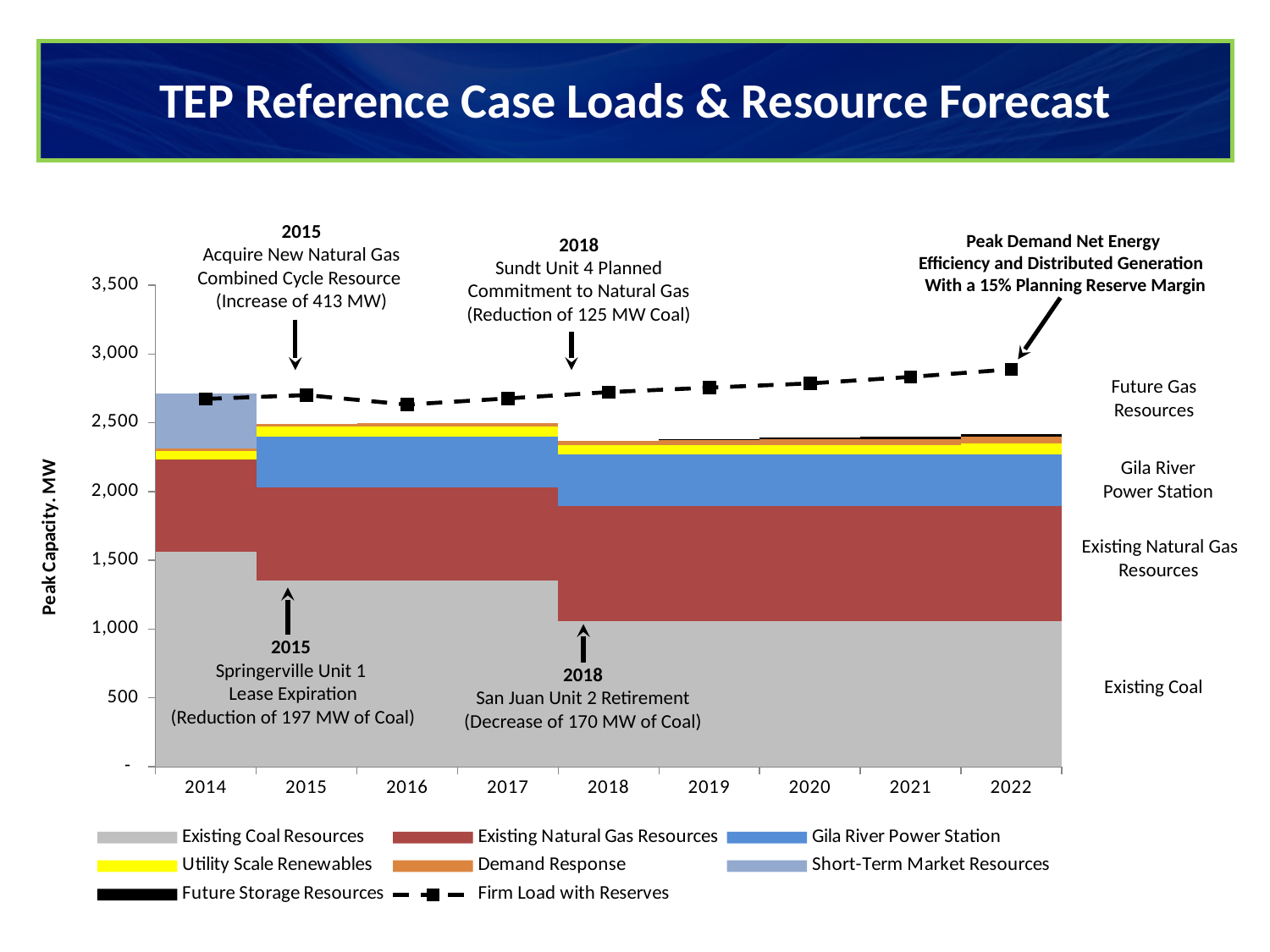
What is the label on the vertical axis of the chart? Peak Capacity, MW Is the Existing Coal Resources value for 2014 larger or smaller than the value for 2018? larger Is the Existing Coal Resources value for 2022 greater or less than 1,500? less What kind of chart is shown on the slide? Stacked bar chart with a line Is the Firm Load with Reserves value for 2022 greater or less than 3,000? less Is the total stacked capacity for 2014 greater or less than 2,500? greater What is the title of the chart on the slide? TEP Reference Case Loads & Resource Forecast Which year is the only one in which Short-Term Market Resources appear in the stack? 2014 How many series does the chart's legend list? 8 How many years are shown along the x axis of the chart? 9 Does the Firm Load with Reserves line generally rise or fall from 2016 to 2022? rise